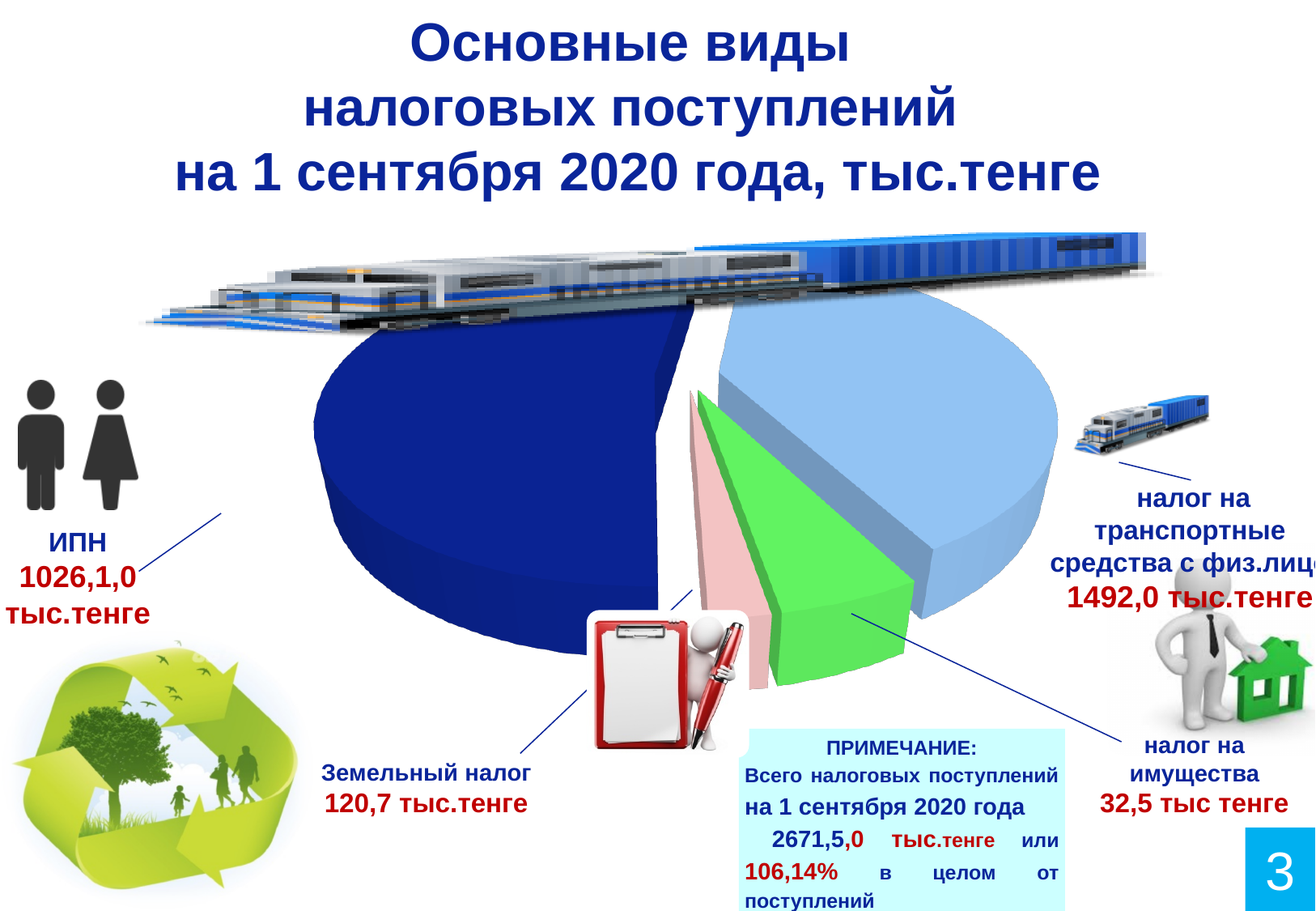
What is the title of the chart on the slide? Основные виды налоговых поступлений на 1 сентября 2020 года, тыс.тенге Which tax type has the lowest value on the chart? налог на имущества How many slices does the pie chart have? 4 What is the value for налог на транспортные средства с физ.лиц? 1492,0 тыс.тенге What is the value shown for ИПН? 1026,1,0 тыс.тенге What is the value for Земельный налог? 120,7 тыс.тенге What is the value for налог на имущества? 32,5 тыс тенге Which is larger, Земельный налог or налог на имущества? Земельный налог What is the difference between Земельный налог and налог на имущества? 88,2 тыс.тенге Which tax type has the highest value on the chart? налог на транспортные средства с физ.лиц What kind of chart is shown on the slide? pie chart According to the note on the slide, what is the total of all tax receipts as of 1 September 2020? 2671,5,0 тыс.тенге